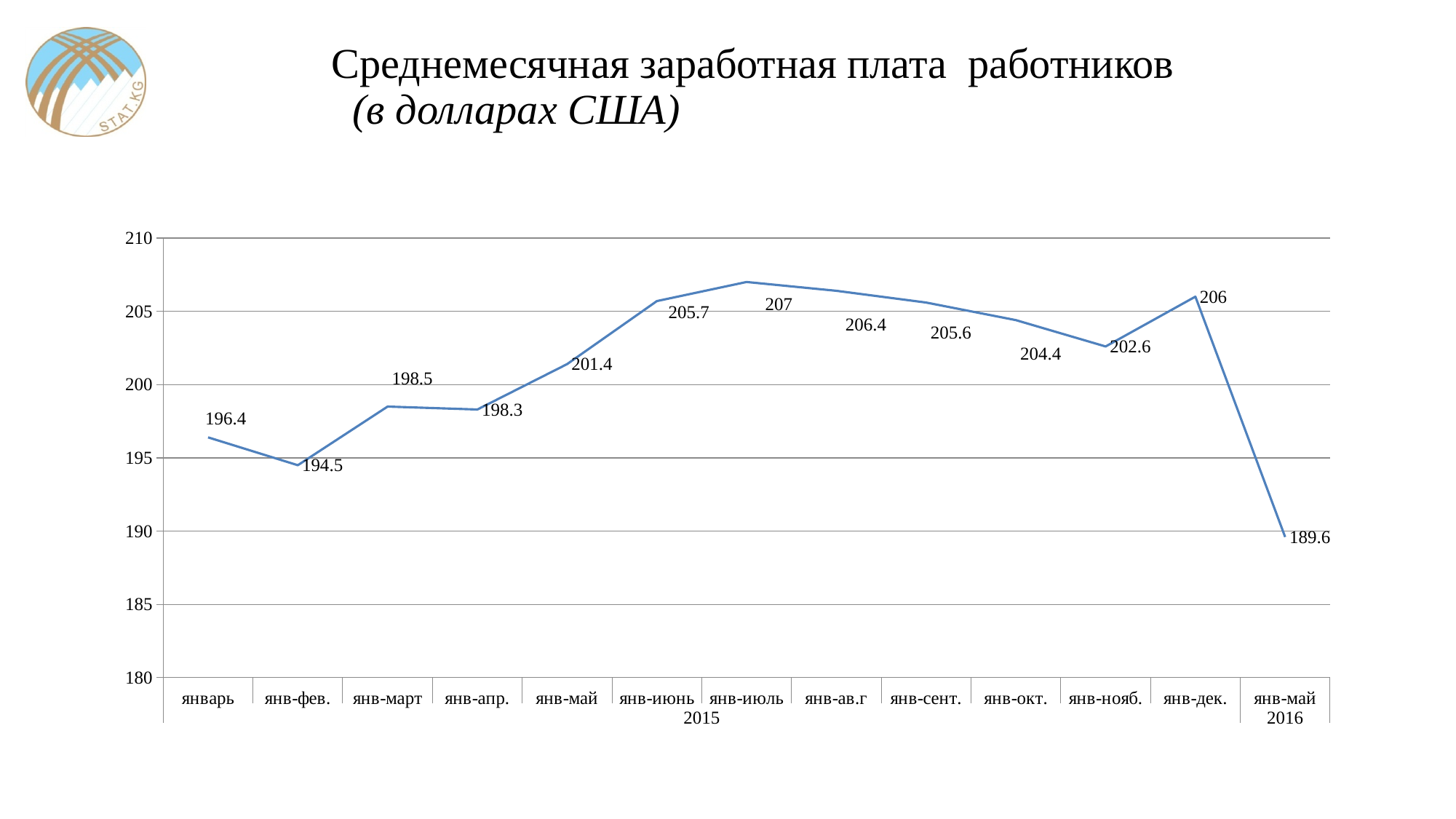
What is the value for янв-май 2016? 189.6 What is the value for янв-нояб.? 202.6 Which period has the lowest value? янв-май 2016 Does the value rise or fall from янв-фев. to янв-июль? rise What is the title of the chart? Среднемесячная заработная плата работников (в долларах США) What is the value for январь? 196.4 Which period has the highest value? янв-июль How many data points are plotted on the chart? 13 Which is larger, the value for янв-март or the value for янв-апр.? янв-март What type of chart is shown on the slide? line chart What is the value for янв-июль 2015? 207 What is the difference between the values for янв-дек. and янв-май 2016? 16.4